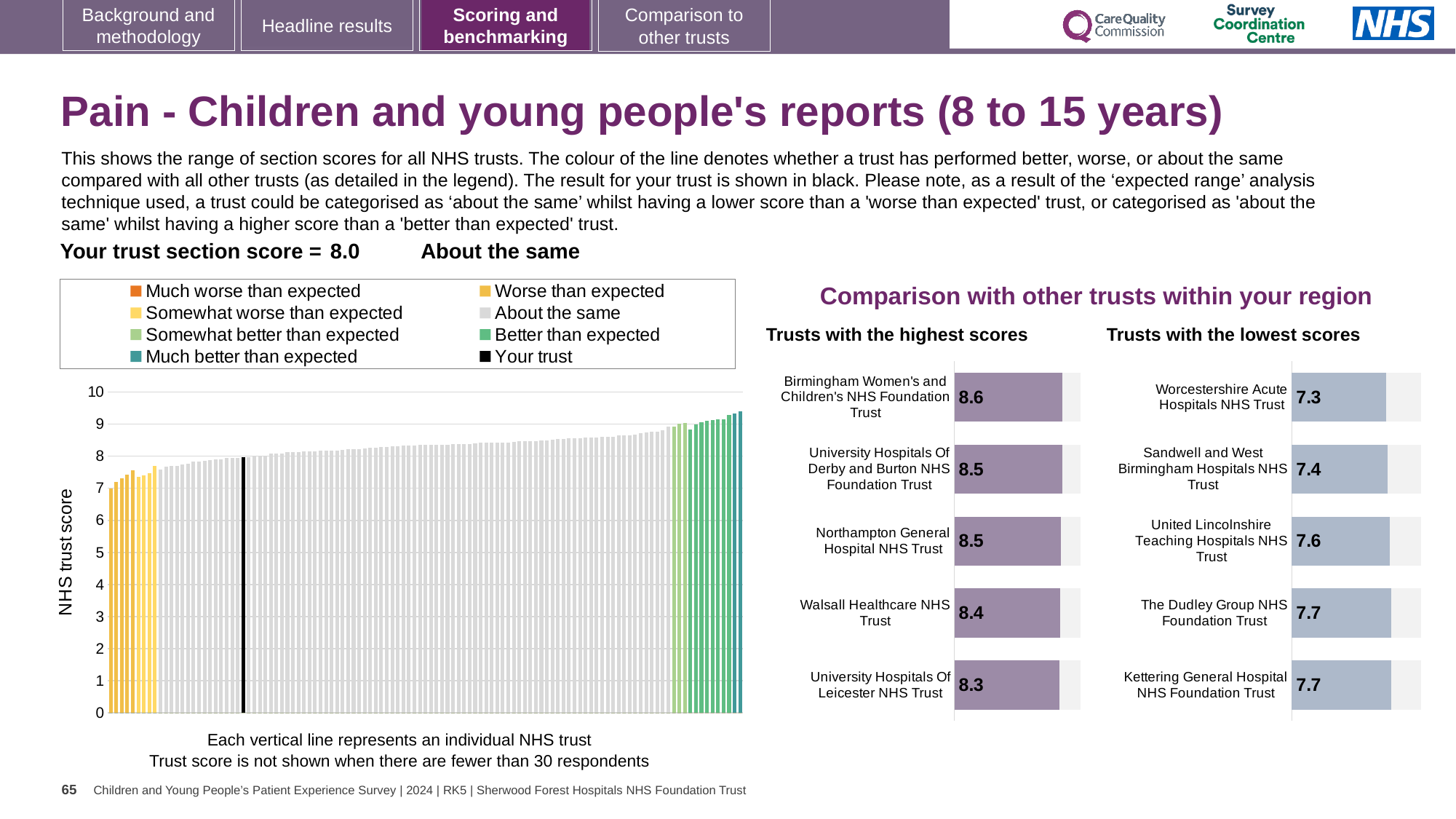
In the 'Trusts with the lowest scores' chart, which trust has the lowest score? Worcestershire Acute Hospitals NHS Trust In the 'Trusts with the lowest scores' chart, what is the score for United Lincolnshire Teaching Hospitals NHS Trust? 7.6 In the main 'NHS trust score' chart on the left, what is the section score for your trust (the black bar)? 8.0 In the 'Trusts with the highest scores' chart, what is the score for Birmingham Women's and Children's NHS Foundation Trust? 8.6 In the 'Trusts with the highest scores' chart, what is the score for Walsall Healthcare NHS Trust? 8.4 In the 'Trusts with the lowest scores' chart, which has the larger score: Sandwell and West Birmingham Hospitals NHS Trust or The Dudley Group NHS Foundation Trust? The Dudley Group NHS Foundation Trust How many trusts are listed in the 'Trusts with the lowest scores' chart? 5 In the 'Trusts with the lowest scores' chart, what is the score for Worcestershire Acute Hospitals NHS Trust? 7.3 How many entries does the legend of the main 'NHS trust score' chart list? 8 In the main 'NHS trust score' chart on the left, do the bar heights rise or fall from left to right? rise In the 'Trusts with the highest scores' chart, what is the difference between the scores of Birmingham Women's and Children's NHS Foundation Trust and University Hospitals Of Leicester NHS Trust? 0.3 In the 'Trusts with the highest scores' chart, which trust has the highest score? Birmingham Women's and Children's NHS Foundation Trust